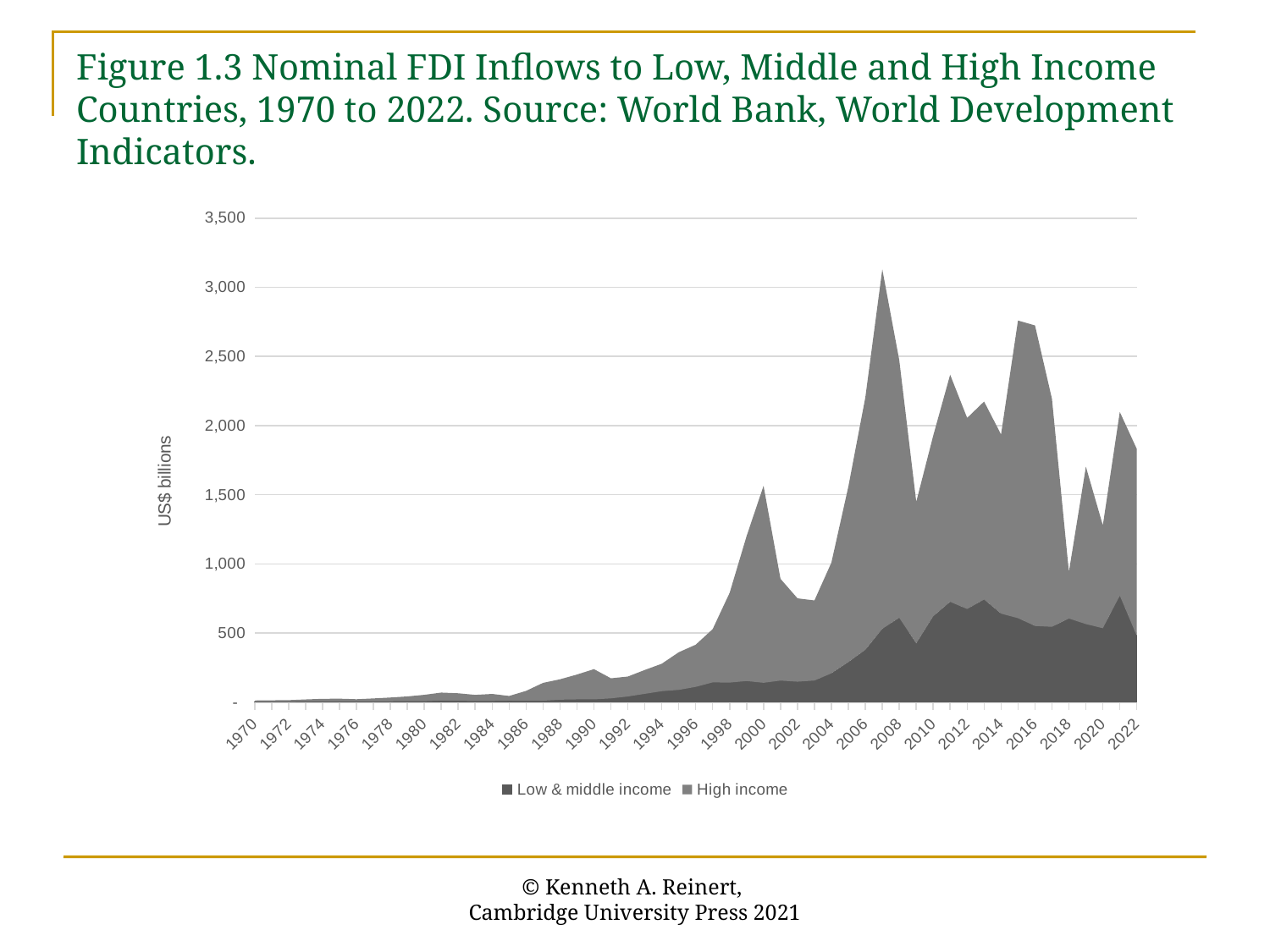
What is the label on the vertical axis? US$ billions Is the total FDI inflow in 2007 greater or less than 3,000? greater Is the total FDI inflow in 2016 greater or less than 2,500? greater Is the total FDI inflow in 2000 greater or less than 1,000? greater What kind of chart is shown on the slide? Stacked area chart How many series does the legend list? 2 Overall, do total FDI inflows rise or fall between 1970 and 2007? rise In which year does the total FDI inflow (both series combined) reach its highest point? 2007 Which year has the larger total FDI inflow, 2007 or 2016? 2007 What are the two series named in the legend? Low & middle income and High income